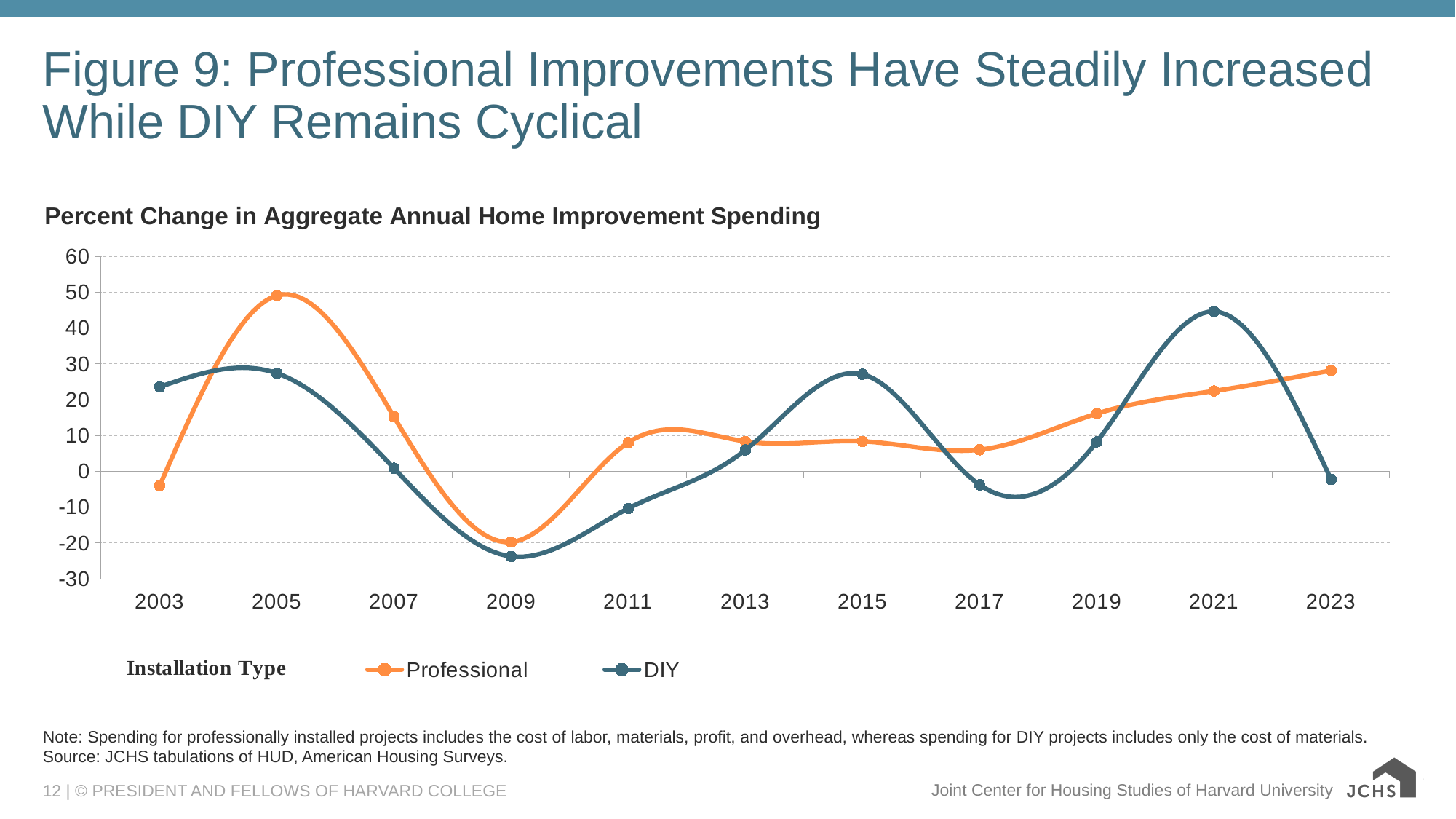
Is the value for Professional in 2023 greater or less than 20? greater In which year does the Professional series reach its highest value? 2005 In 2021, which series has the larger value, Professional or DIY? DIY What is the chart's subtitle above the plot area? Percent Change in Aggregate Annual Home Improvement Spending In which year does the DIY series reach its highest value? 2021 Does the Professional series rise or fall from 2017 to 2023? rise Is the value for DIY in 2009 greater or less than -20? less How many series does the legend list? 2 In which year does the DIY series reach its lowest value? 2009 Is the value for Professional in 2005 greater or less than 40? greater What kind of chart is shown on the slide? line chart How many years are plotted along the x axis? 11